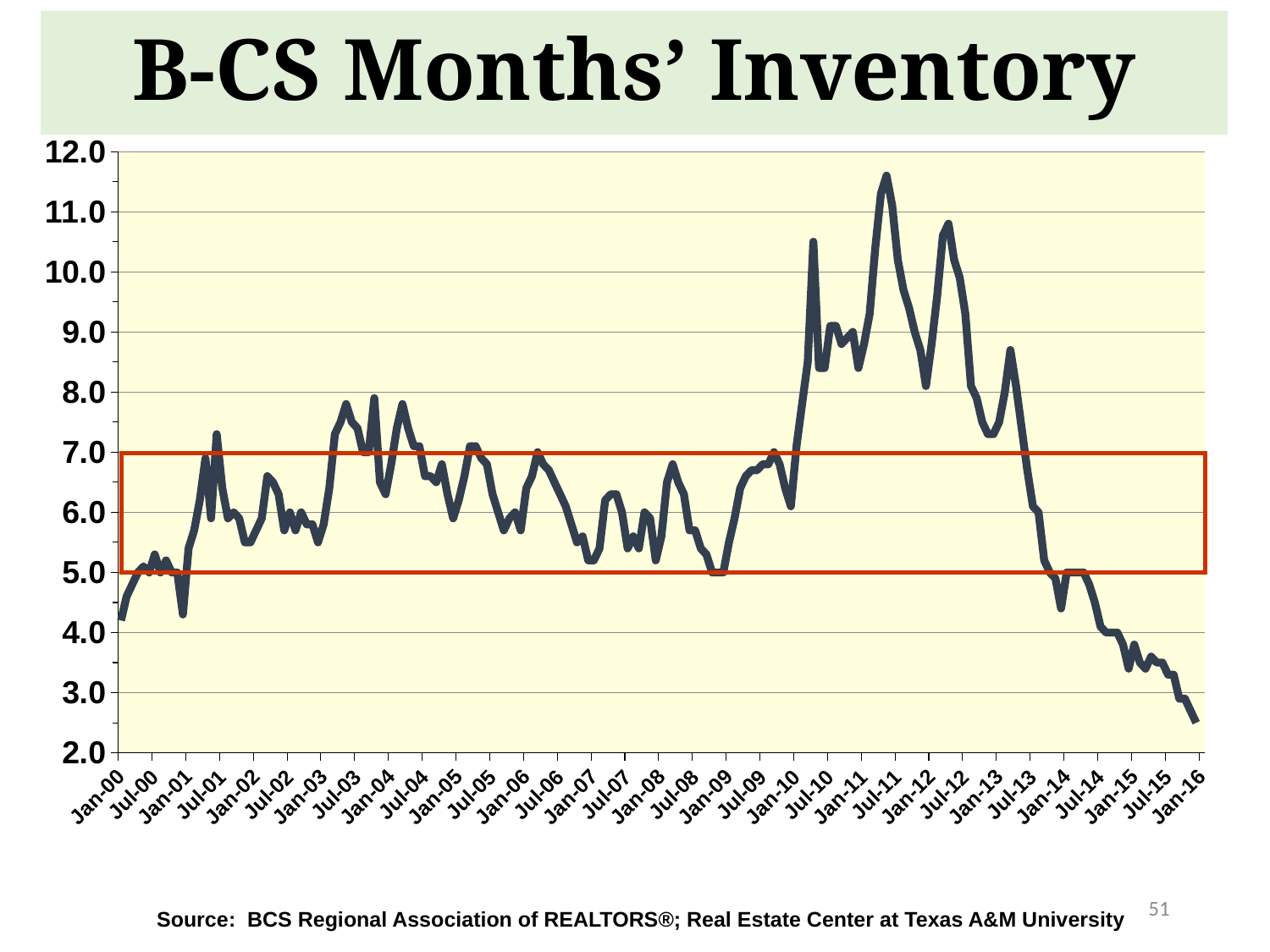
Around which x-axis label does the line reach its highest value? Jul-11 Which is higher, the peak near Jul-11 or the peak near Jul-12? Jul-11 At which x-axis label does the line reach its lowest value? Jan-16 Is the peak value near Jul-11 greater or less than 11.0? greater Is the value at Jan-16 greater or less than 3.0? less Does the line generally rise or fall from Jul-11 to Jan-16? fall Between which two y-axis values does the red rectangle on the chart span? 5.0 and 7.0 What is the title of the chart? B-CS Months' Inventory What kind of chart is shown on the slide? line chart Is the value at Jul-15 greater or less than 4.0? less Which is higher, the value at Jan-00 or the value at Jan-16? Jan-00